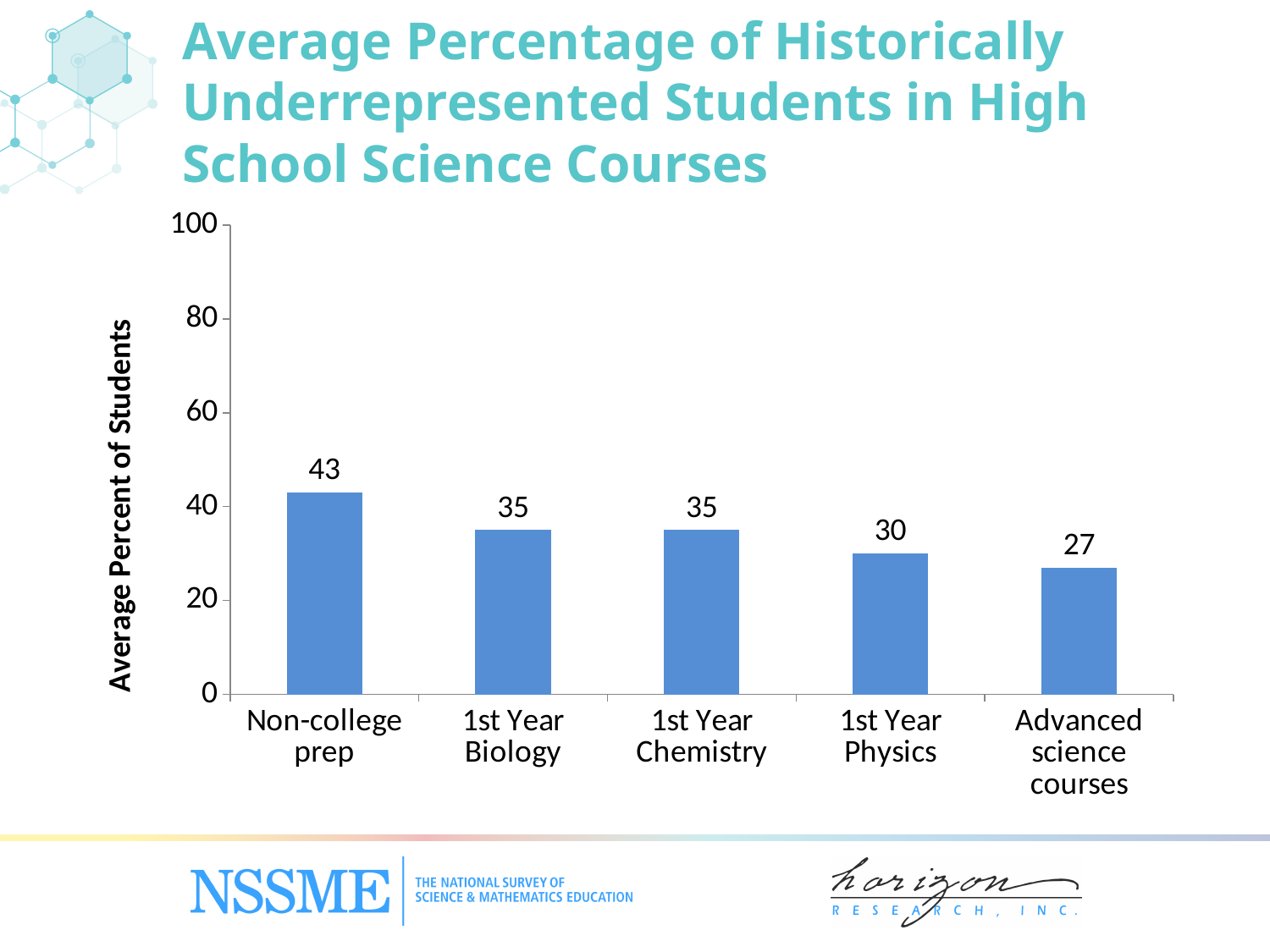
What is the average percent of historically underrepresented students in Non-college prep courses? 43 What is the value for 1st Year Physics? 30 What is the label of the y axis? Average Percent of Students What is the difference between the values for 1st Year Biology and 1st Year Physics? 5 How many course categories are shown on the x axis? 5 Which course category has the highest average percent of students? Non-college prep Which is larger, the value for 1st Year Physics or the value for Advanced science courses? 1st Year Physics What is the value for 1st Year Chemistry? 35 What is the difference between the values for Non-college prep and Advanced science courses? 16 Which course category has the lowest average percent of students? Advanced science courses What kind of chart is shown on the slide? Bar chart What is the value for Advanced science courses? 27